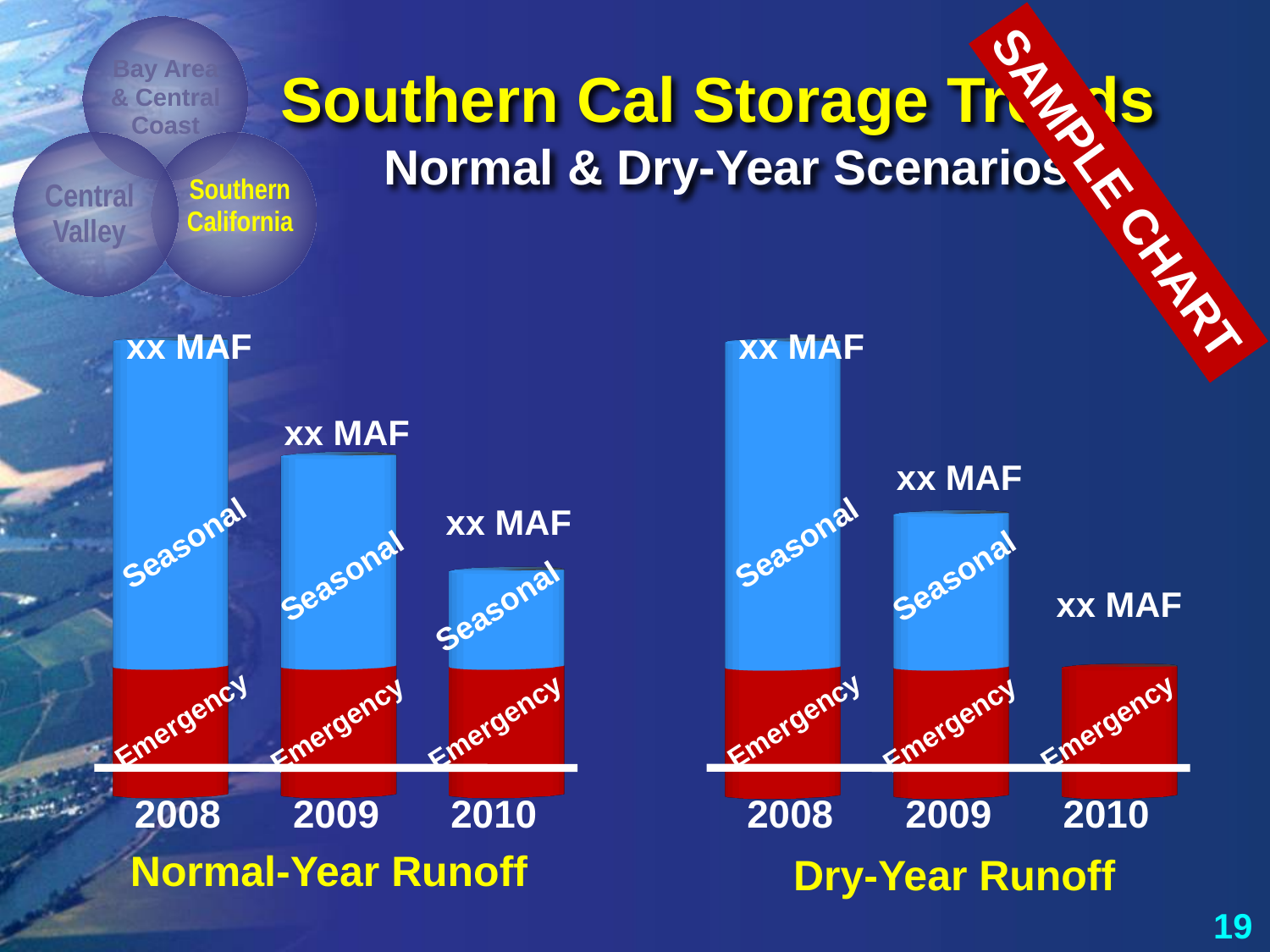
In the Dry-Year Runoff chart, which year has the shortest bar? 2010 In the Dry-Year Runoff chart, which year has the tallest bar? 2008 What are the two stacked segments labelled in each bar of the Normal-Year Runoff chart? Seasonal and Emergency In the Dry-Year Runoff chart, which segment is larger in the 2008 bar, Seasonal or Emergency? Seasonal What is the main title of the slide containing the two charts? Southern Cal Storage Trends In the Normal-Year Runoff chart, is the 2009 bar taller or shorter than the 2010 bar? Taller How many years are shown on the x axis of the Dry-Year Runoff chart? 3 In the Dry-Year Runoff chart, what colour is the Emergency segment of each bar? Red What kind of chart is the Normal-Year Runoff chart? Stacked bar chart In the Normal-Year Runoff chart, which year has the shortest bar? 2010 In the Dry-Year Runoff chart, do the bar heights rise or fall from 2008 to 2010? Fall In the Normal-Year Runoff chart, which year has the tallest bar? 2008